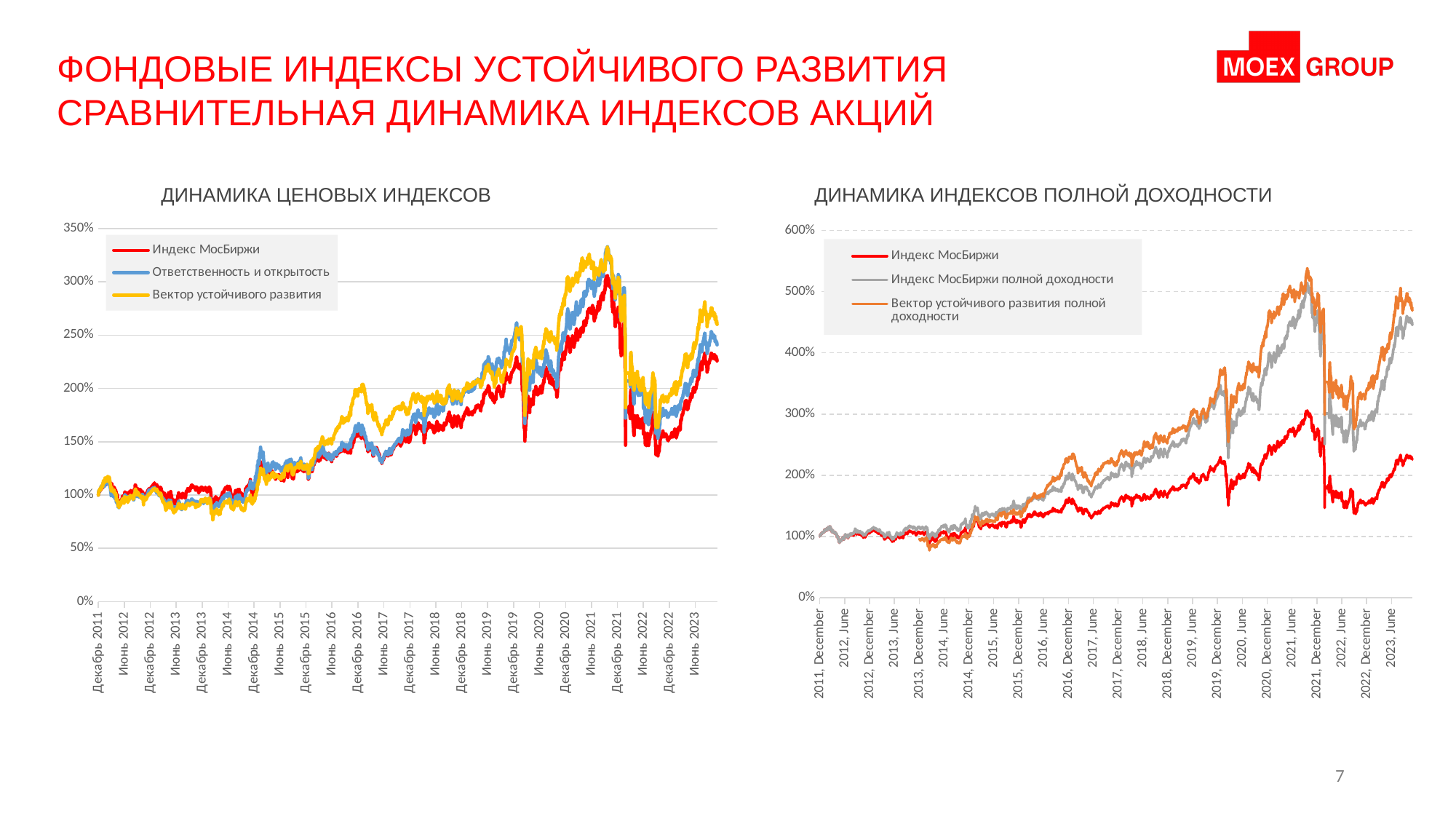
In the right chart "ДИНАМИКА ИНДЕКСОВ ПОЛНОЙ ДОХОДНОСТИ", do the series overall rise or fall from December 2011 to 2023? Rise In the right chart "ДИНАМИКА ИНДЕКСОВ ПОЛНОЙ ДОХОДНОСТИ", is the value of "Индекс МосБиржи" at the end of the period (2023) greater or less than 300%? less What kind of chart is the left chart titled "ДИНАМИКА ЦЕНОВЫХ ИНДЕКСОВ"? Line chart In the left chart "ДИНАМИКА ЦЕНОВЫХ ИНДЕКСОВ", is the peak value of "Вектор устойчивого развития" around 2021 greater or less than 300%? greater In the left chart "ДИНАМИКА ЦЕНОВЫХ ИНДЕКСОВ", which series is shown in yellow? Вектор устойчивого развития In the left chart "ДИНАМИКА ЦЕНОВЫХ ИНДЕКСОВ", at the end of the period (2023), which is higher: "Вектор устойчивого развития" or "Индекс МосБиржи"? Вектор устойчивого развития How many series does the legend of the left chart "ДИНАМИКА ЦЕНОВЫХ ИНДЕКСОВ" list? 3 In the right chart "ДИНАМИКА ИНДЕКСОВ ПОЛНОЙ ДОХОДНОСТИ", at the end of the period (2023), which is higher: "Вектор устойчивого развития полной доходности" or "Индекс МосБиржи"? Вектор устойчивого развития полной доходности In the right chart "ДИНАМИКА ИНДЕКСОВ ПОЛНОЙ ДОХОДНОСТИ", is the peak value of "Вектор устойчивого развития полной доходности" around 2021 greater or less than 500%? greater How many series does the legend of the right chart "ДИНАМИКА ИНДЕКСОВ ПОЛНОЙ ДОХОДНОСТИ" list? 3 In the right chart "ДИНАМИКА ИНДЕКСОВ ПОЛНОЙ ДОХОДНОСТИ", which series is shown in grey? Индекс МосБиржи полной доходности What kind of chart is the right chart titled "ДИНАМИКА ИНДЕКСОВ ПОЛНОЙ ДОХОДНОСТИ"? Line chart